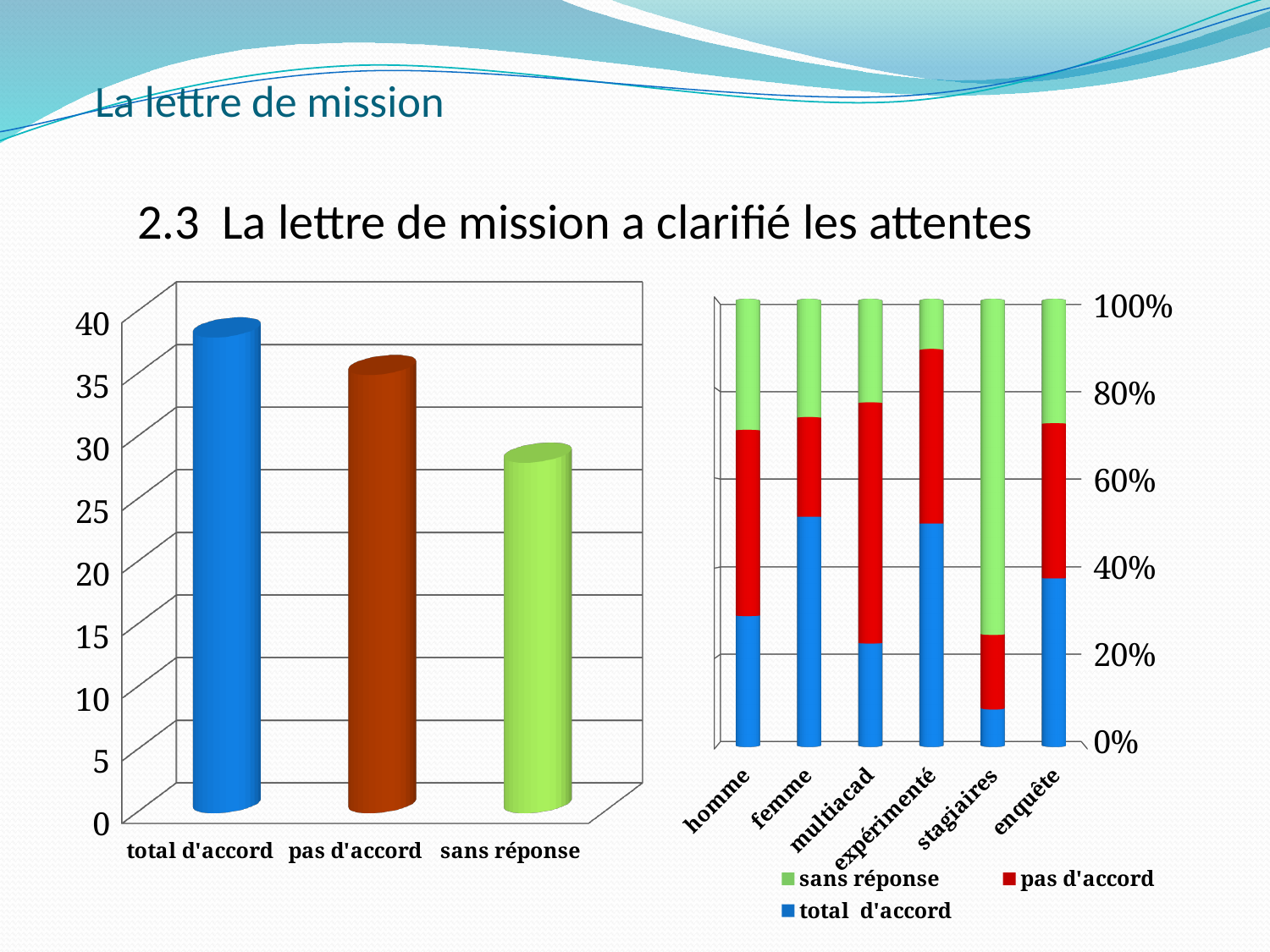
On the right chart, which is larger, the total d'accord share for femme or for homme? femme What kind of chart is the left chart? bar chart On the right chart, how many categories are shown on the x axis? 6 On the left chart, how many categories are shown? 3 On the left chart, which category has the highest bar? total d'accord On the right chart, is the total d'accord share for stagiaires greater or less than 20%? less On the left chart, is the value for sans réponse greater or less than 30? less On the right chart, which category has the largest sans réponse share? stagiaires On the left chart, which category has the lowest bar? sans réponse On the right chart, how many series does the legend list? 3 On the left chart, is the value for total d'accord greater or less than 35? greater